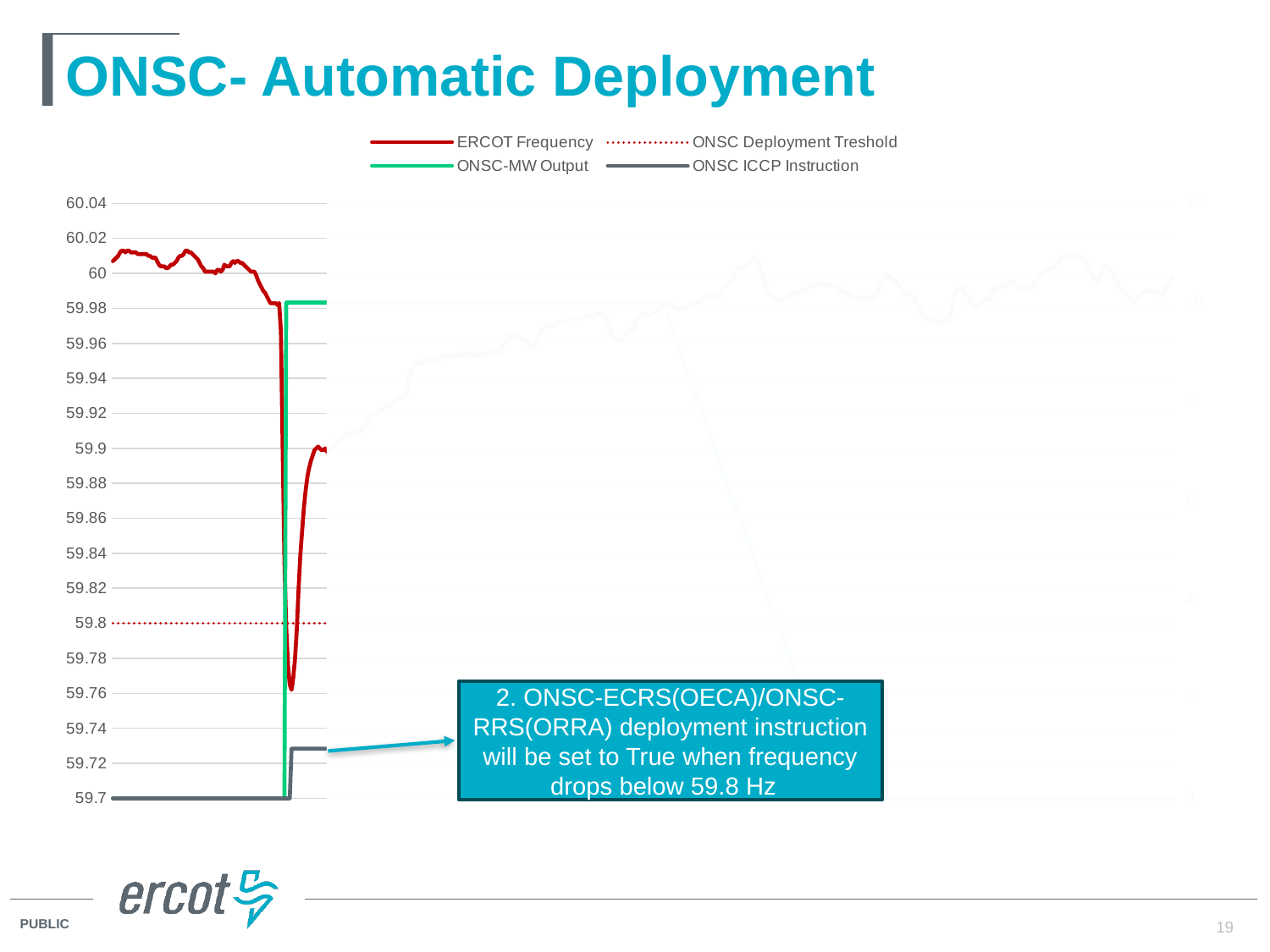
What kind of chart is shown on the slide? line chart Does the ONSC ICCP Instruction line rise or fall along the x axis? rise Does the ERCOT Frequency line drop below the ONSC Deployment Treshold line? yes Is the lowest point of the ERCOT Frequency line greater or less than 59.8? less At what value on the vertical axis is the ONSC Deployment Treshold line drawn? 59.8 Which series is drawn as a dotted line in the legend? ONSC Deployment Treshold Is the ERCOT Frequency value at the start of the chart greater or less than 59.9? greater What colour is the ERCOT Frequency line? red How many series does the chart legend list? 4 According to the slide, below what frequency is the deployment instruction set to True? 59.8 Hz